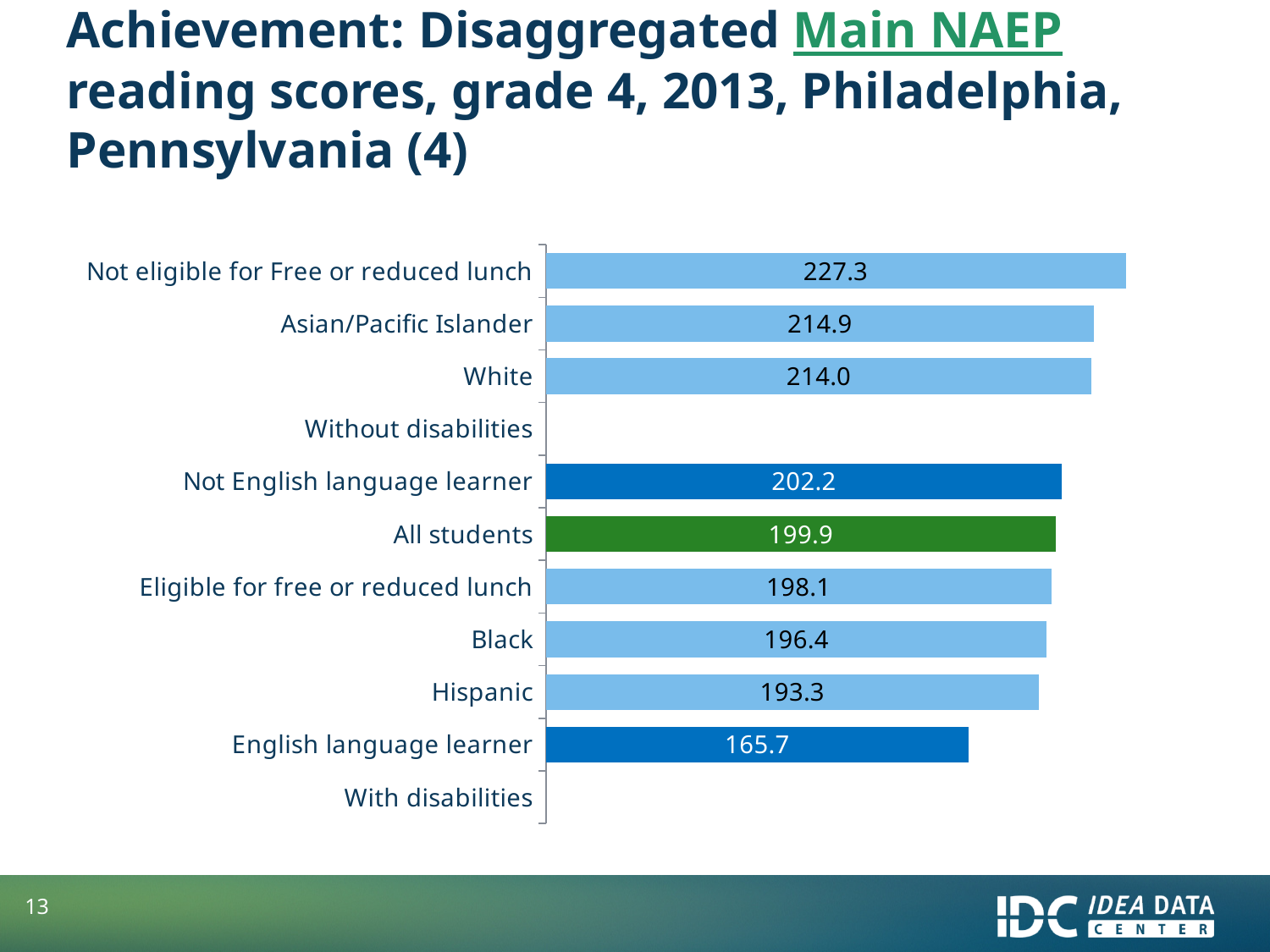
What is the reading score for Hispanic students? 193.3 What is the difference between the scores for All students and Eligible for free or reduced lunch? 1.8 Which two categories on the chart have no bar or value shown? Without disabilities and With disabilities What is the reading score for All students? 199.9 Which has a higher reading score, Black or Hispanic? Black What is the difference between the scores for Not eligible for Free or reduced lunch and English language learner? 61.6 What type of chart is shown on the slide? Bar chart How many category labels are listed on the chart's axis? 11 What is the reading score for English language learner? 165.7 Which category has the highest reading score? Not eligible for Free or reduced lunch Which category with a plotted bar has the lowest reading score? English language learner What is the reading score for Not English language learner? 202.2